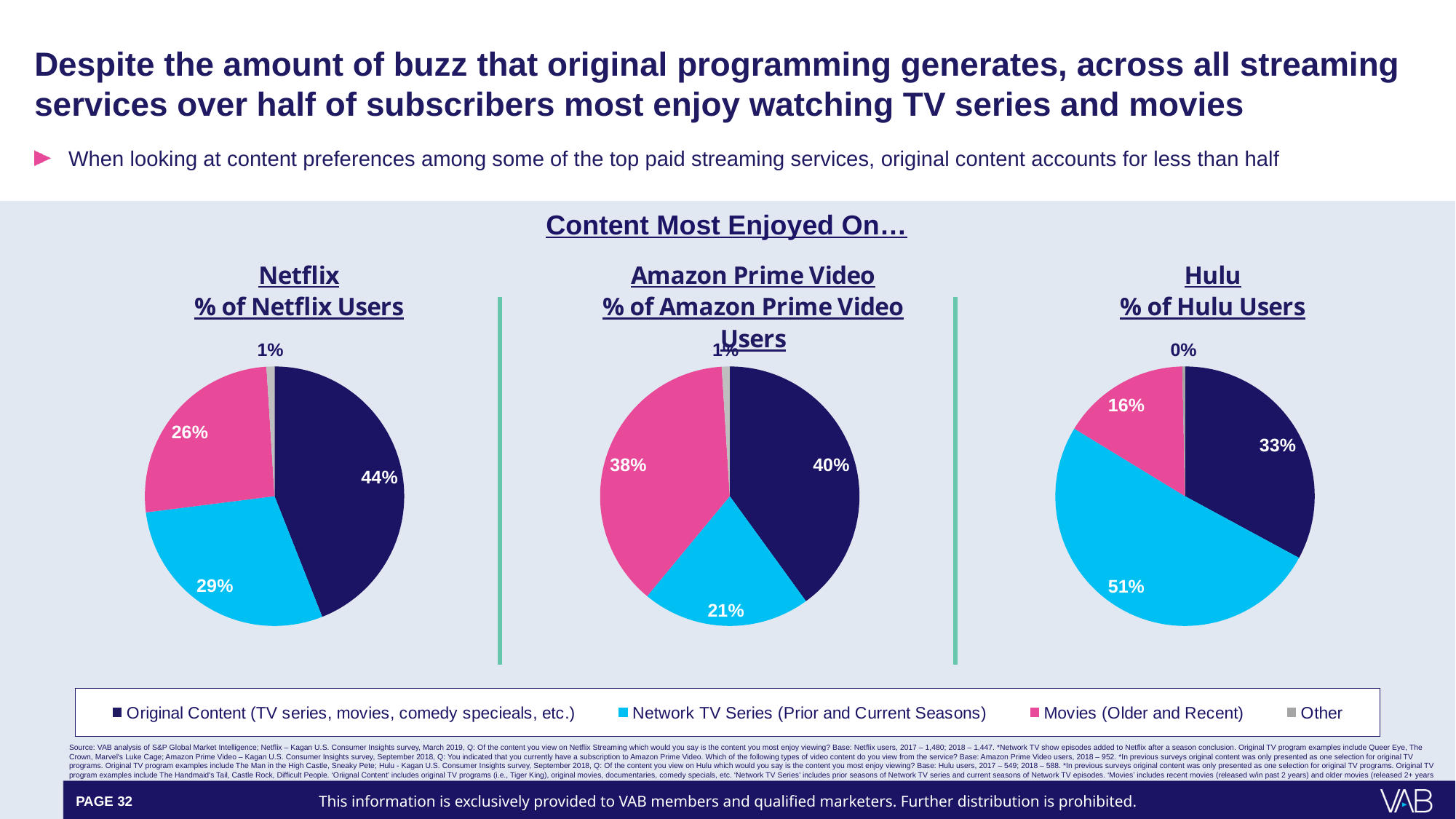
What type of chart is used for the Netflix, Amazon Prime Video and Hulu data? Pie chart In the Amazon Prime Video pie chart, what is the difference between the Original Content share and the Network TV Series share? 19 percentage points What is the overall title above the three pie charts? Content Most Enjoyed On… In the Hulu pie chart, what is the difference between the Network TV Series share and the Original Content share? 18 percentage points In the Hulu pie chart, which category has the smallest share? Other In the Hulu pie chart, what percentage of Hulu users most enjoy Network TV Series (Prior and Current Seasons)? 51% In the Amazon Prime Video pie chart, what percentage of users most enjoy Movies (Older and Recent)? 38% In the Netflix pie chart, which is larger: the share for Network TV Series or the share for Movies? Network TV Series (Prior and Current Seasons) In the Netflix pie chart, which category has the largest share? Original Content (TV series, movies, comedy specieals, etc.) How many series does the legend list? 4 In the Hulu pie chart, what percentage is shown for Other? 0% In the Netflix pie chart, what percentage of Netflix users most enjoy Original Content? 44%